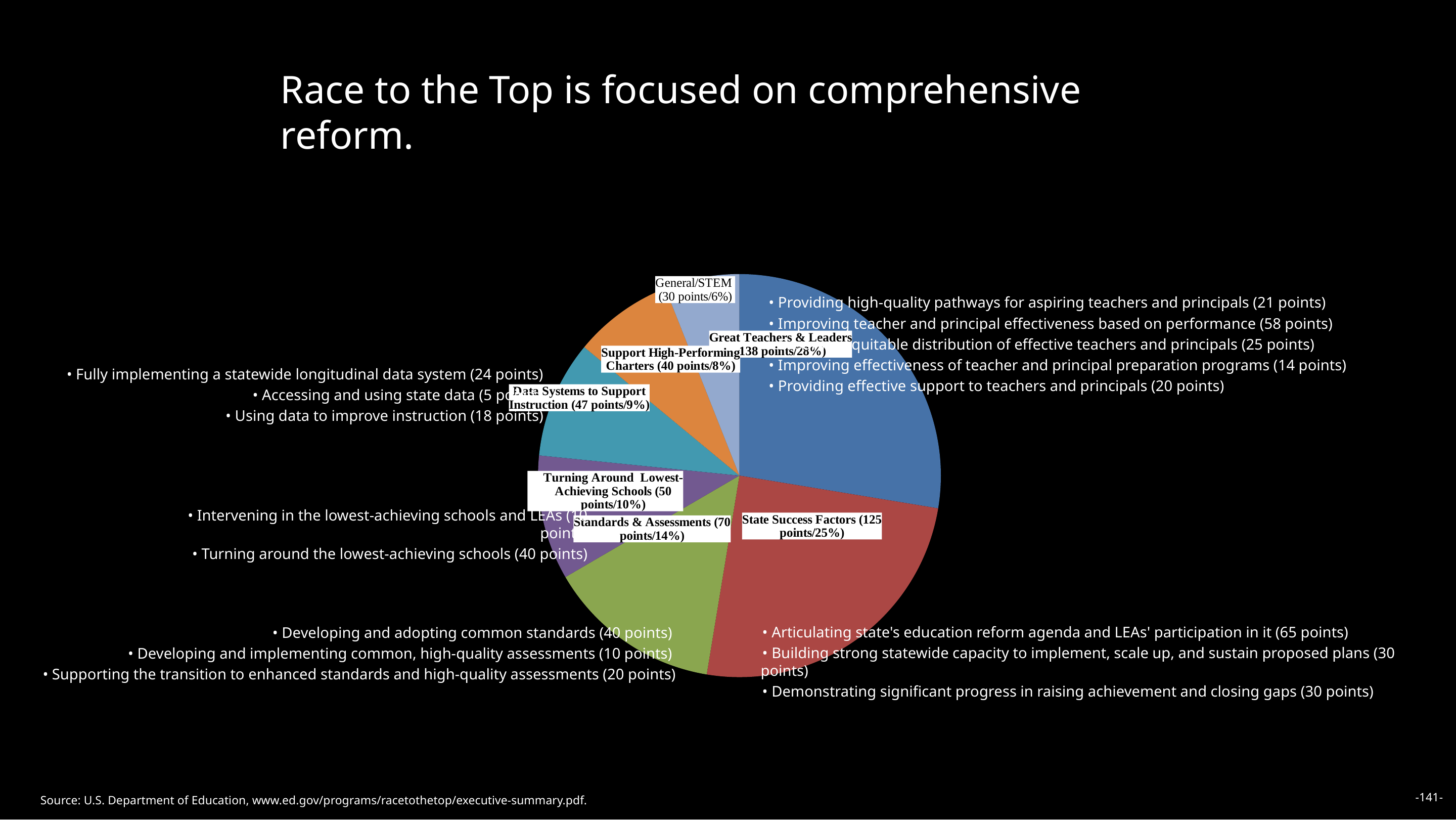
How many points are allocated to State Success Factors? 125 points Which category has the smallest slice of the pie? General/STEM What is the difference in points between Great Teachers & Leaders and State Success Factors? 13 points What kind of chart is shown on the slide? pie chart How many slices does the pie chart have? 7 How many points are allocated to Standards & Assessments? 70 points How many points are allocated to General/STEM? 30 points Which has more points, Data Systems to Support Instruction or Support High-Performing Charters? Data Systems to Support Instruction What share of the pie does Turning Around Lowest-Achieving Schools represent? 10% What share of the pie does Great Teachers & Leaders represent? 28% Which category has the largest slice of the pie? Great Teachers & Leaders What is the title of the slide containing the pie chart? Race to the Top is focused on comprehensive reform.